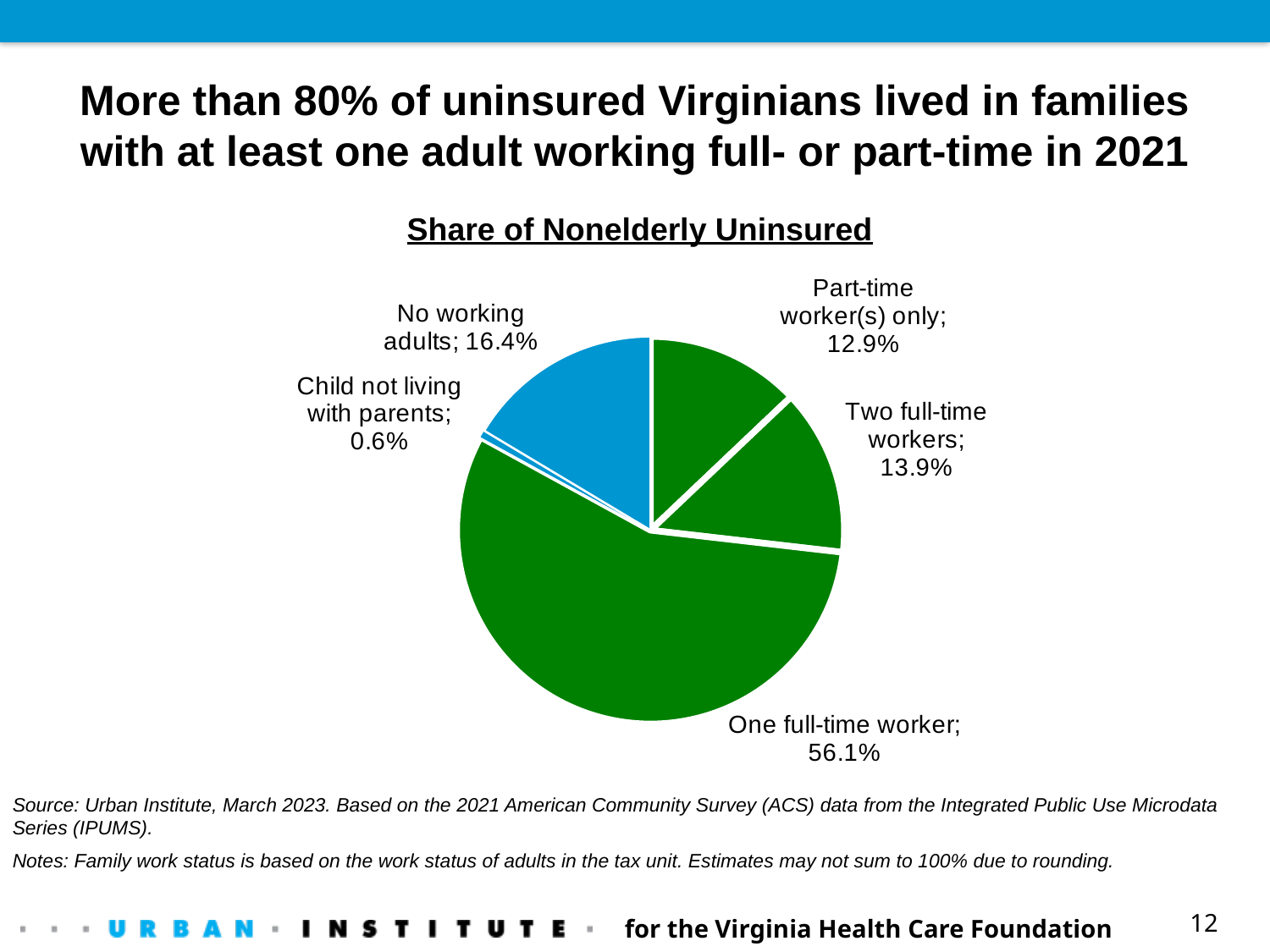
Which is larger: the share for two full-time workers or the share for part-time worker(s) only? Two full-time workers Which category has the largest share of the pie? One full-time worker What kind of chart is shown on the slide? Pie chart What is the title of the chart? Share of Nonelderly Uninsured What share of nonelderly uninsured lived in families with no working adults? 16.4% What share of nonelderly uninsured lived in families with part-time worker(s) only? 12.9% How many categories are shown in the pie chart? 5 What share of nonelderly uninsured lived in families with two full-time workers? 13.9% What is the difference between the share for one full-time worker and the share for no working adults? 39.7% What share of nonelderly uninsured lived in families with one full-time worker? 56.1% Which category has the smallest share of the pie? Child not living with parents What share of nonelderly uninsured were children not living with parents? 0.6%